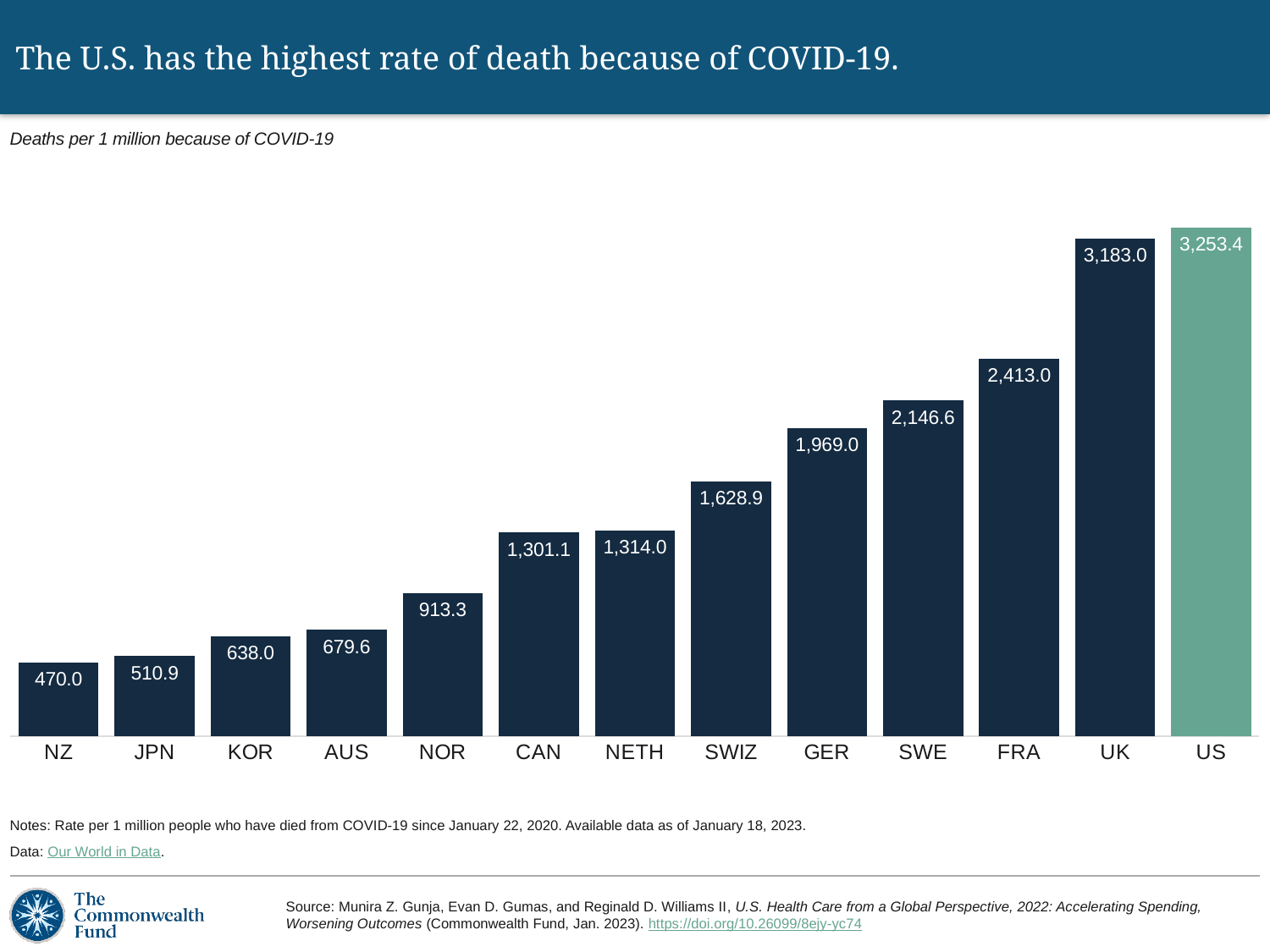
What is the difference between the US and UK values? 70.4 Which is larger, the value for SWIZ or the value for GER? GER Which bar is shown in a different colour from the others? US What is the value for Germany (GER)? 1,969.0 What is the value for Norway (NOR)? 913.3 What is the difference between the FRA and SWE values? 266.4 How many countries are shown in the chart? 13 Which country has the lowest deaths per 1 million? NZ Which country has the highest deaths per 1 million? US What is the value for the US? 3,253.4 Which is larger, the value for KOR or the value for JPN? KOR What kind of chart is shown on the slide? Bar chart